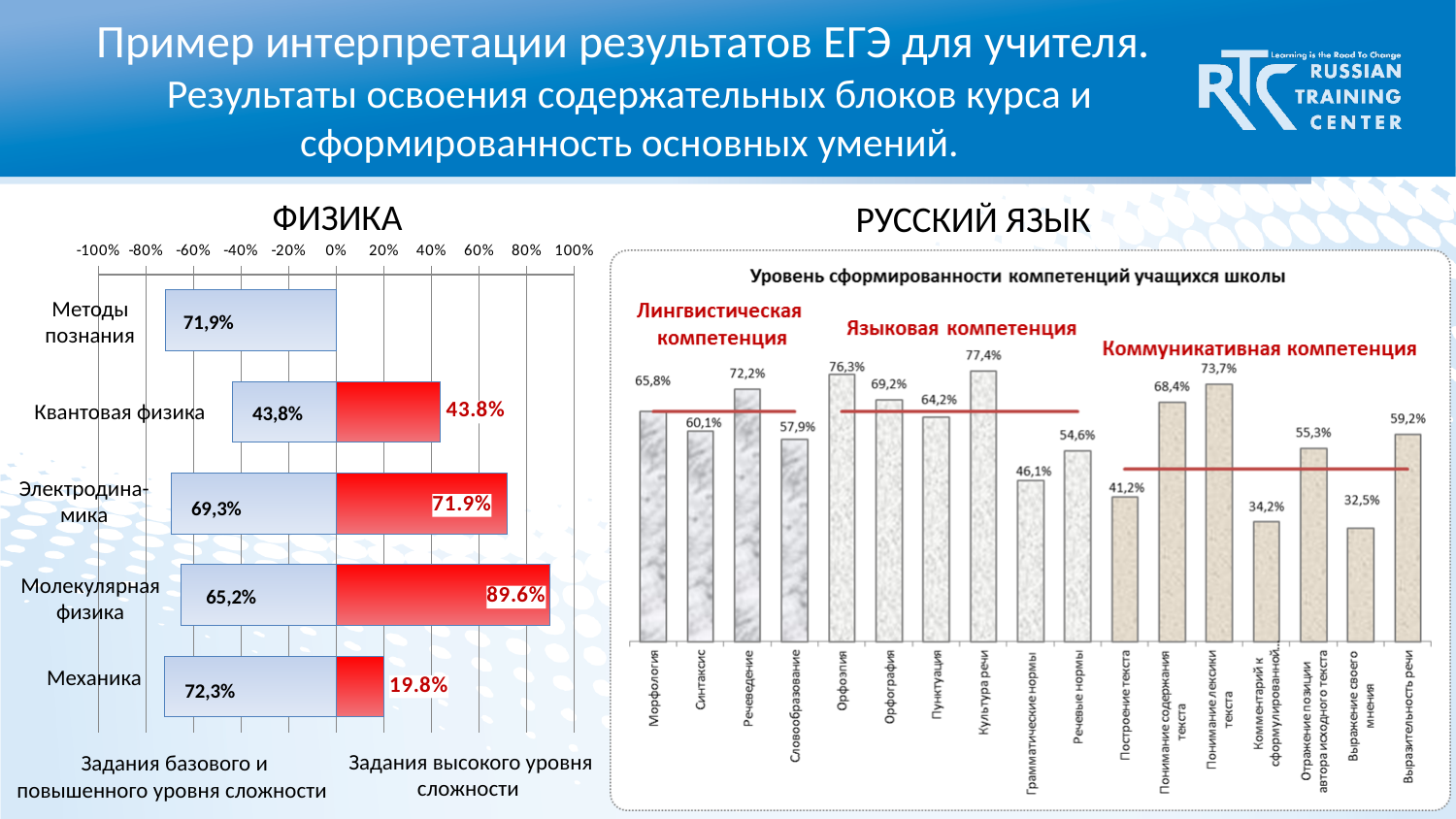
What type of chart is the ФИЗИКА chart? Bar chart On the РУССКИЙ ЯЗЫК chart, which category has the lowest value? Выражение своего мнения On the ФИЗИКА chart, what is the value of the blue bar (Задания базового и повышенного уровня сложности) for Механика? 72,3% On the РУССКИЙ ЯЗЫК chart, what is the difference between the values for Понимание лексики текста and Построение текста? 32,5% On the ФИЗИКА chart, what is the value of the red bar (Задания высокого уровня сложности) for Молекулярная физика? 89.6% On the РУССКИЙ ЯЗЫК chart, which category has the highest value? Культура речи On the РУССКИЙ ЯЗЫК chart, which is larger: the value for Морфология or the value for Синтаксис? Морфология On the ФИЗИКА chart, which category has the lowest red bar (Задания высокого уровня сложности)? Механика On the ФИЗИКА chart, what is the difference between the red bar and the blue bar for Молекулярная физика? 24.4% On the ФИЗИКА chart, how many categories are shown on the vertical axis? 5 On the РУССКИЙ ЯЗЫК chart, what is the value for Орфоэпия? 76,3% On the ФИЗИКА chart, which category has the lowest blue bar (Задания базового и повышенного уровня сложности)? Квантовая физика